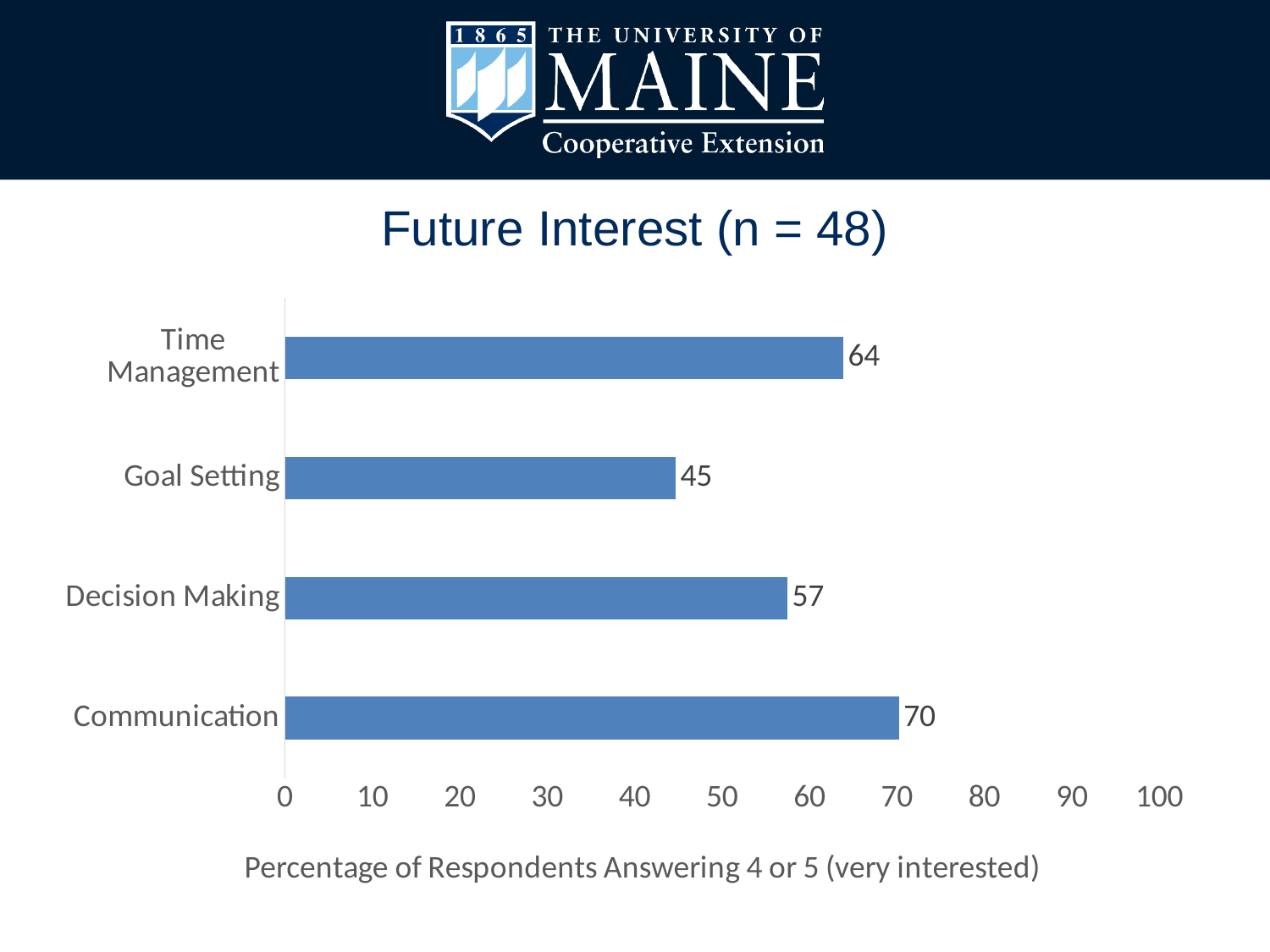
What is the difference between the values for Time Management and Decision Making? 7 How many categories are shown in the chart? 4 What is the value for Time Management? 64 Which is larger, the value for Decision Making or the value for Goal Setting? Decision Making What is the difference between the values for Communication and Goal Setting? 25 What kind of chart is shown on the slide? Bar chart Which category has the lowest value? Goal Setting What is the value for Decision Making? 57 Which category has the highest value? Communication What is the title of the chart? Future Interest (n = 48) What is the value for Communication? 70 What is the value for Goal Setting? 45